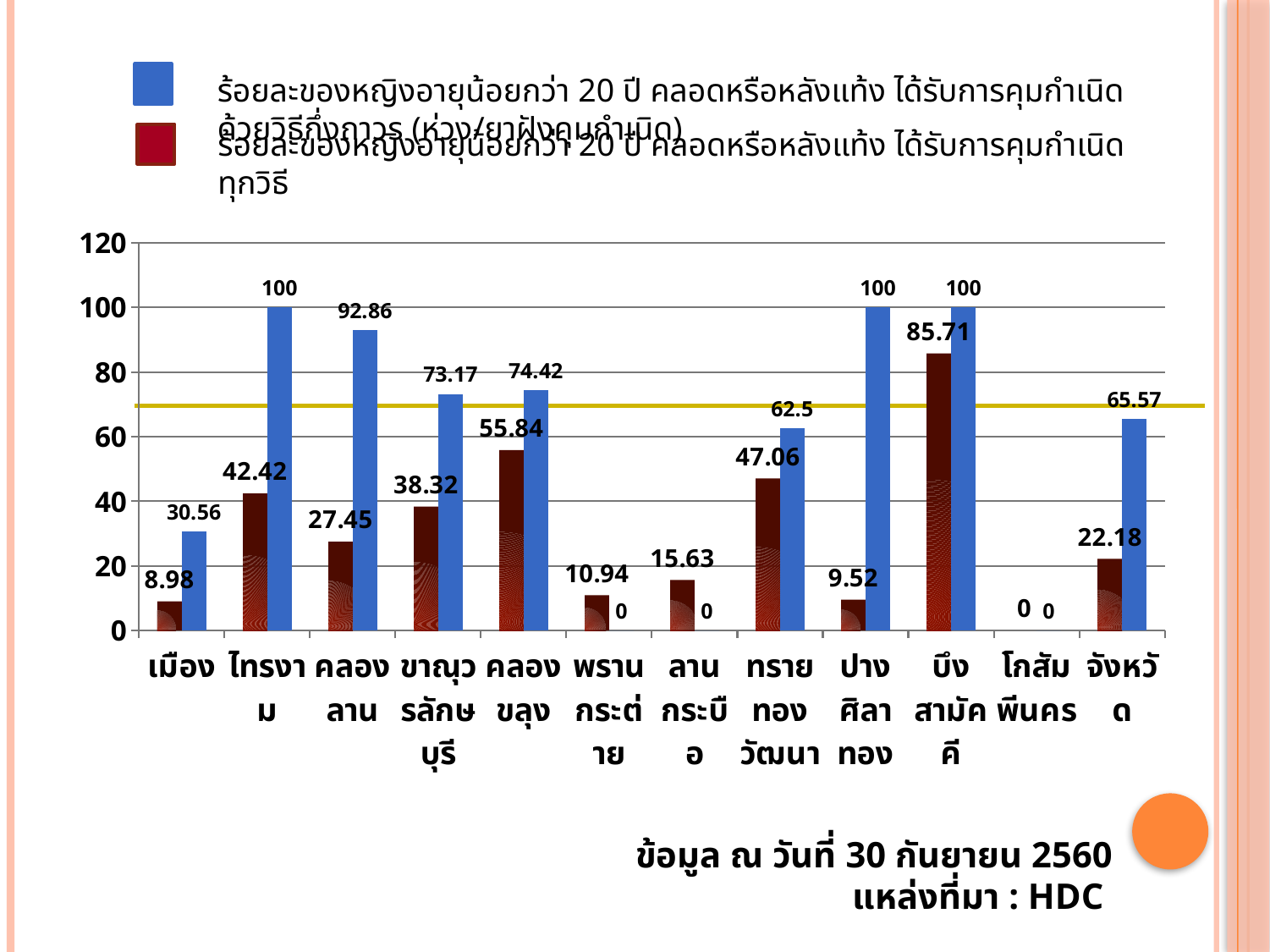
How many categories are shown on the x axis? 12 What is the value of the blue series (คุมกำเนิดด้วยวิธีกึ่งถาวร) for คลองลาน? 92.86 What kind of chart is shown on the slide? bar chart Is the blue series value for ขาณุวรลักษบุรี greater or less than 60? greater Which is larger for คลองขลุง: the blue series value or the dark red series value? the blue series (74.42) Which category has the lowest value in the dark red series (ทุกวิธี)? โกสัมพีนคร What is the value of the dark red series (ได้รับการคุมกำเนิดทุกวิธี) for บึงสามัคคี? 85.71 Which category has the highest value in the dark red series (ทุกวิธี)? บึงสามัคคี What is the difference between the blue and dark red values for ทรายทองวัฒนา? 15.44 How many categories have a blue series value of 100? 3 What is the value of the blue series for จังหวัด? 65.57 How many series does the legend list? 2